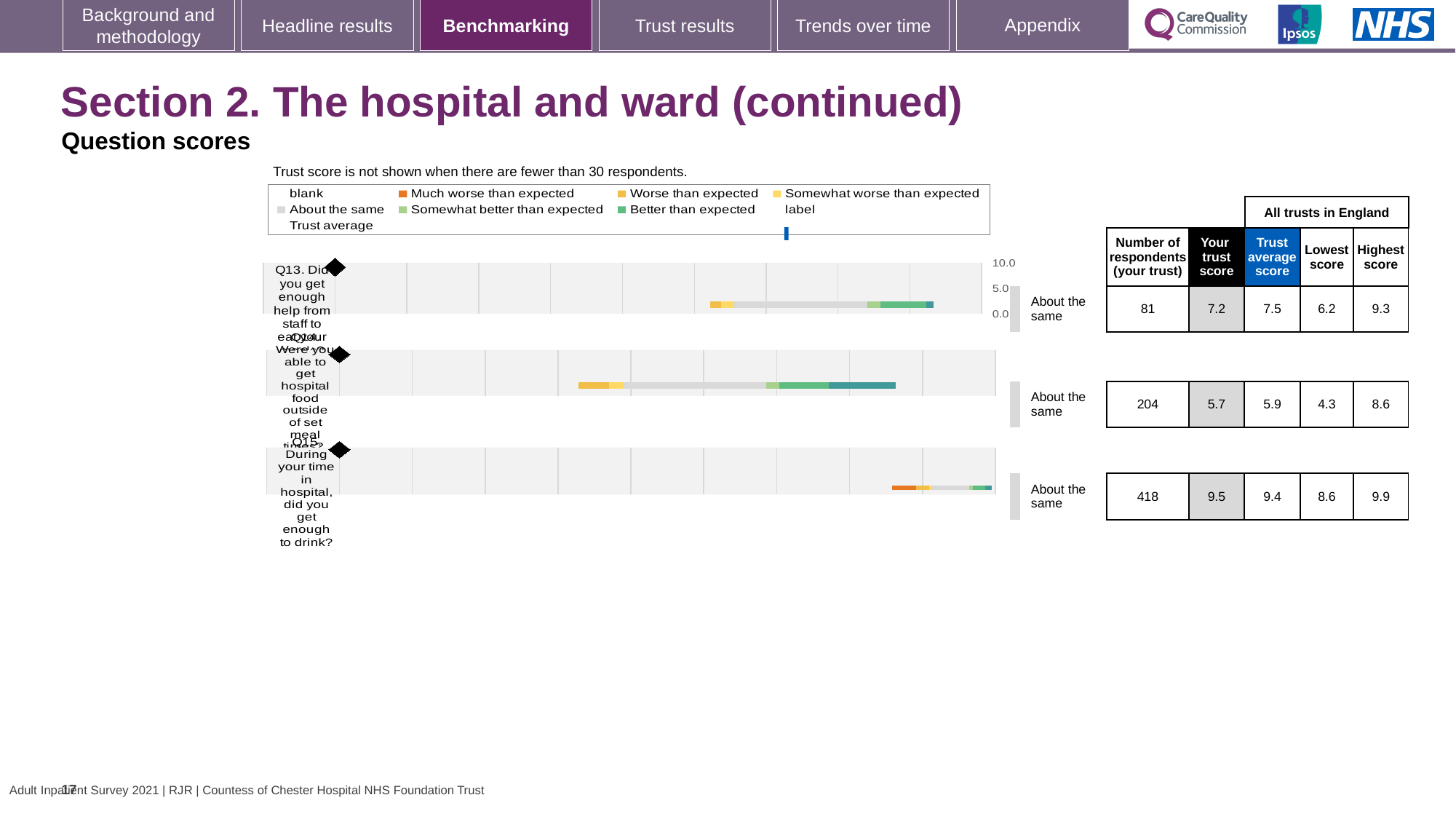
How many respondents (your trust) are shown for Q14 (Were you able to get hospital food outside of set meal times?)? 204 What is the difference between the highest score and the lowest score for Q14? 4.3 Which question has the lowest number of respondents? Q13 What is the trust average score for Q15 (During your time in hospital, did you get enough to drink?)? 9.4 What benchmark category is shown for Q14? About the same Is the 'Your trust score' for Q15 greater or less than 5.0? greater What kind of chart is used to show the question scores? Bar chart Which question has the highest 'Your trust score'? Q15 How many questions are plotted on the slide? 3 What is the lowest score across all trusts in England for Q13? 6.2 What is the 'Your trust score' for Q13 (Did you get enough help from staff to eat your meals?)? 7.2 For Q13, which is larger: your trust score or the trust average score? Trust average score